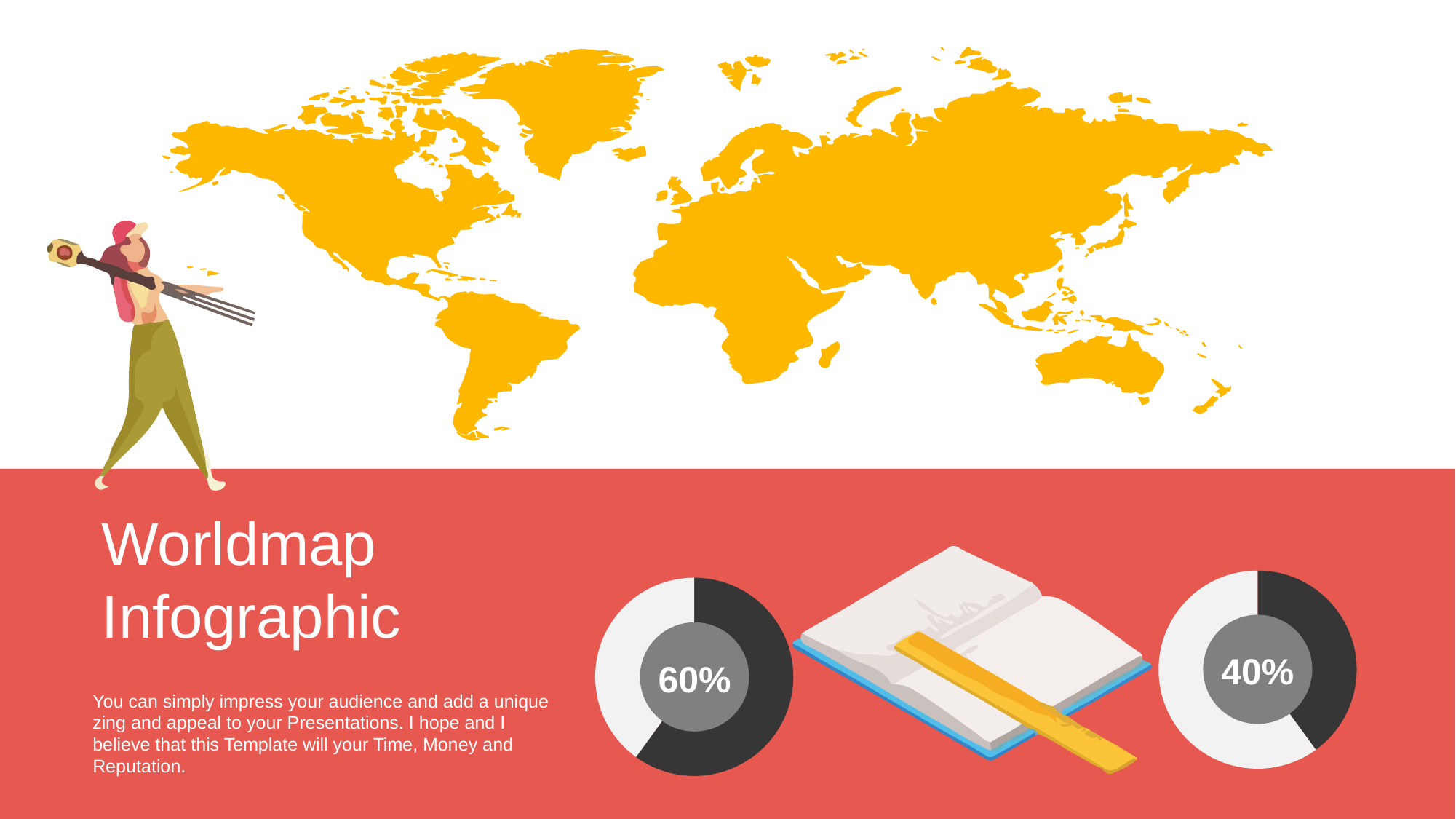
What kind of chart is used to display the 60% and 40% values? donut chart What is the title of the slide containing the two donut charts? Worldmap Infographic How many donut charts are on the slide? 2 What colour is the filled portion of the ring in the left donut chart? black Which donut chart shows the smaller percentage, the left one or the right one? the right one Is the value on the right donut chart greater or less than 50%? less What percentage is shown in the centre of the left donut chart? 60% What percentage is shown in the centre of the right donut chart? 40% Which donut chart shows the larger percentage, the left one or the right one? the left one What is the difference between the percentage on the left donut chart and the percentage on the right donut chart? 20% Is the value on the left donut chart greater or less than 50%? greater